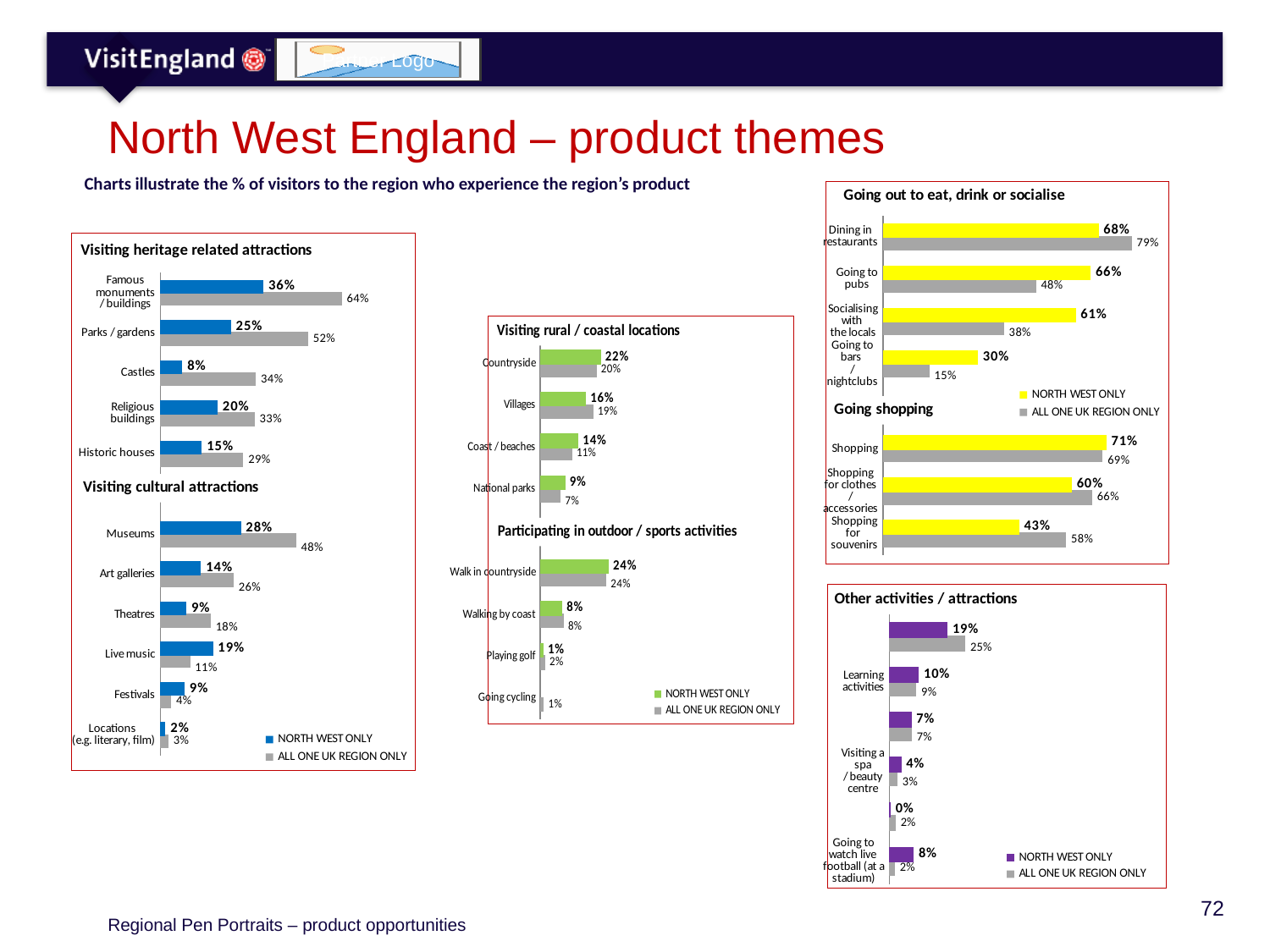
In the 'Visiting heritage related attractions' chart, what is the difference between the ALL ONE UK REGION ONLY and NORTH WEST ONLY values for Parks / gardens? 27% How many series does the legend list in the 'Other activities / attractions' chart? 2 In the 'Going out to eat, drink or socialise' chart, what is the NORTH WEST ONLY value for Going to pubs? 66% In the 'Participating in outdoor / sports activities' chart, what is the ALL ONE UK REGION ONLY value for Playing golf? 2% In the 'Going out to eat, drink or socialise' chart, which category has the lowest ALL ONE UK REGION ONLY value? Going to bars / nightclubs In the 'Visiting heritage related attractions' chart, which category has the highest NORTH WEST ONLY value? Famous monuments / buildings In the 'Visiting cultural attractions' chart, what is the ALL ONE UK REGION ONLY value for Museums? 48% In the 'Visiting cultural attractions' chart, how many categories are shown? 6 In the 'Visiting heritage related attractions' chart, what is the NORTH WEST ONLY value for Castles? 8% In the 'Visiting cultural attractions' chart, which is larger for Live music: the NORTH WEST ONLY value or the ALL ONE UK REGION ONLY value? NORTH WEST ONLY In the 'Visiting rural / coastal locations' chart, what is the NORTH WEST ONLY value for Villages? 16% In the 'Going shopping' chart, what is the difference between the ALL ONE UK REGION ONLY and NORTH WEST ONLY values for Shopping for souvenirs? 15%